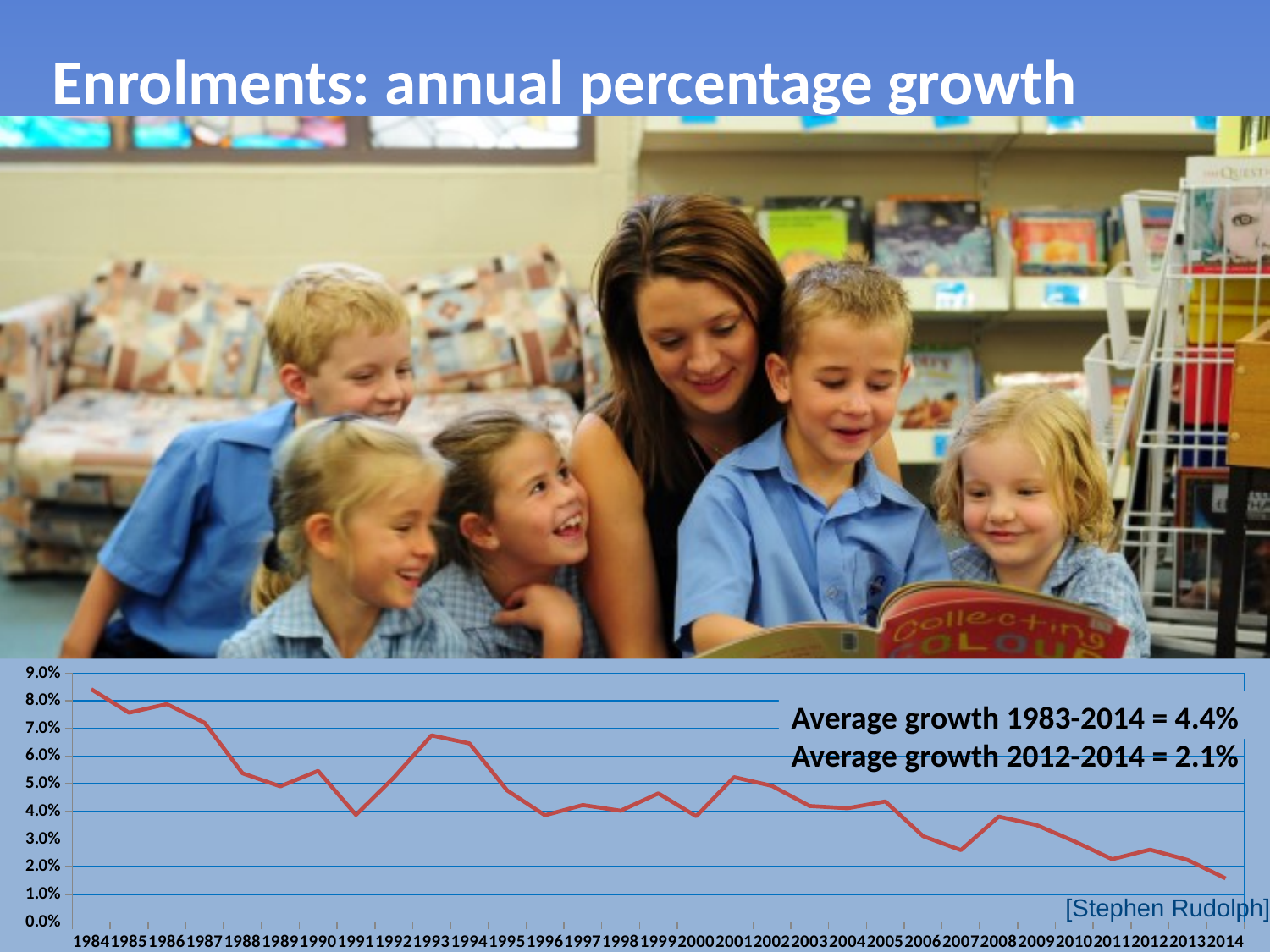
What kind of chart is shown on the slide? line chart Which year has the larger value, 1993 or 1996? 1993 Overall, do the values rise or fall from 1984 to 2014? fall Is the value for 1993 greater or less than 6.0%? greater Which year has the lowest annual percentage growth? 2014 Which year has the highest annual percentage growth? 1984 What is the average growth for 2012-2014 stated on the chart? 2.1% Is the value for 2007 greater or less than 3.0%? less What is the average growth for 1983-2014 stated on the chart? 4.4% How many years are shown on the x axis? 31 Is the value for 1984 greater or less than 8.0%? greater